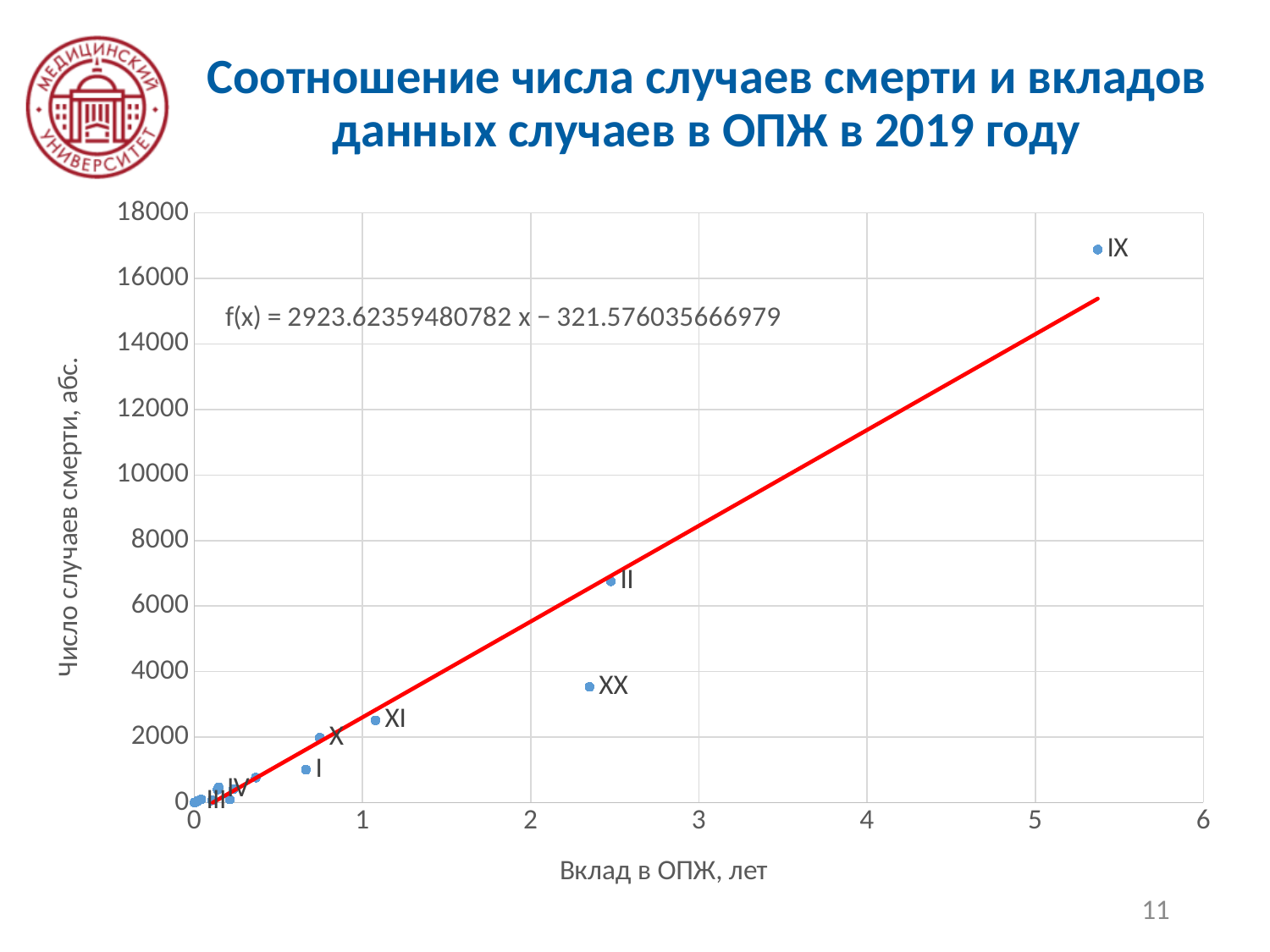
Which point has more deaths, XI or I? XI Is the number of deaths for point IX greater or less than 16000? greater What is the equation of the trend line shown on the chart? f(x) = 2923.62359480782 x − 321.576035666979 What kind of chart is shown on the slide? Scatter chart Is the number of deaths for point II greater or less than 8000? less Which point has more deaths, II or XX? II Is the contribution to life expectancy for point IX greater or less than 5 years? greater Do the number of deaths generally rise or fall as the contribution to life expectancy increases along the x axis? Rise Which labelled point has the largest contribution to life expectancy (Вклад в ОПЖ)? IX Which labelled point has the highest number of deaths (Число случаев смерти)? IX